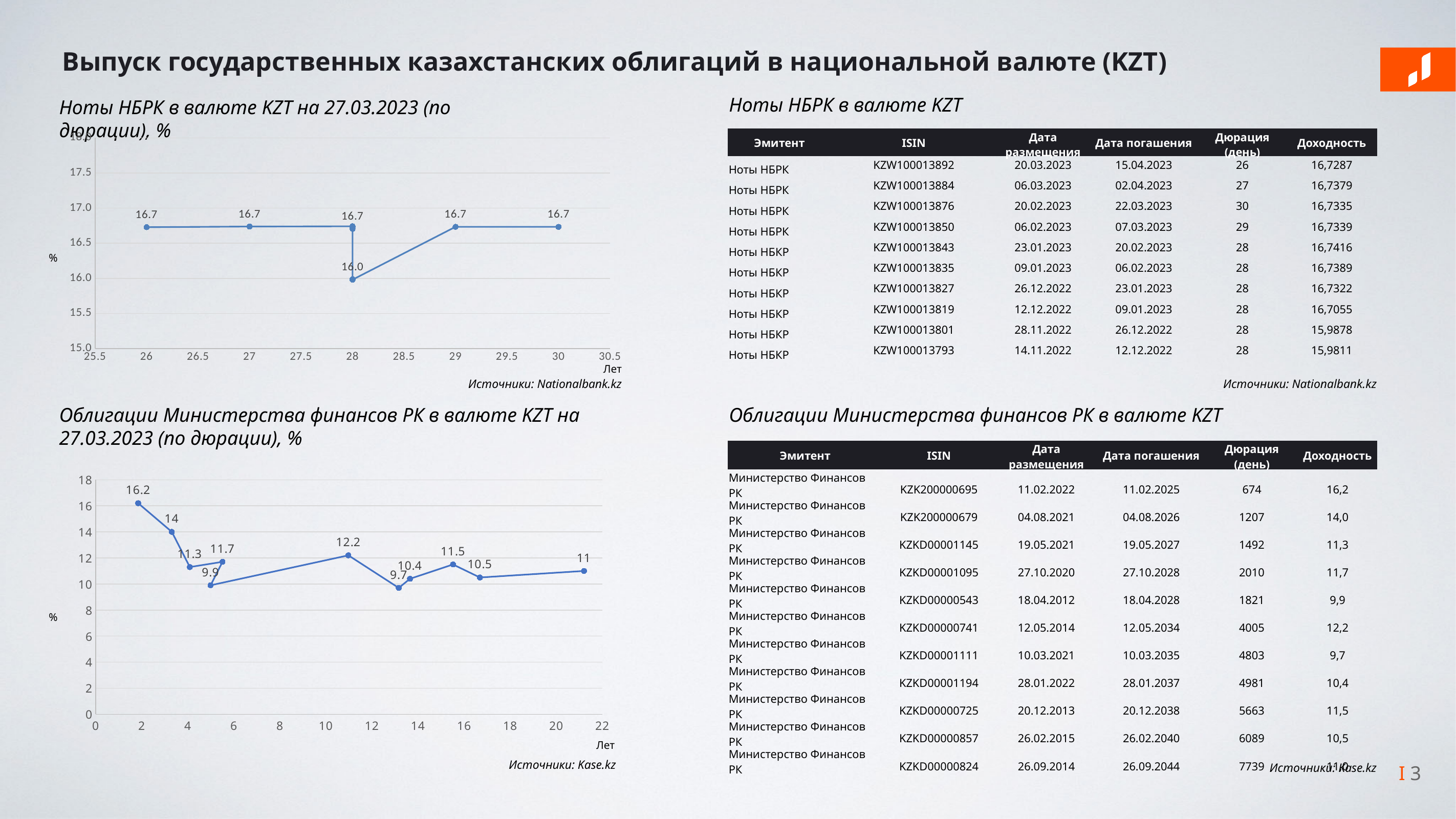
In the bottom-left chart (Облигации Министерства финансов РК), what is the highest plotted value? 16.2 In the top-left chart (Ноты НБРК), what is the lowest plotted value? 16.0 In the bottom-left chart (Облигации Министерства финансов РК), do the values overall rise or fall from the leftmost point to the rightmost point? fall In the bottom-left chart (Облигации Министерства финансов РК), how many data points are plotted? 11 What is the x-axis label of the bottom-left chart (Облигации Министерства финансов РК)? Лет In the bottom-left chart (Облигации Министерства финансов РК), what is the lowest plotted value? 9.7 In the bottom-left chart (Облигации Министерства финансов РК), is the value of the rightmost point (at about 21 years) greater or less than 10? greater In the top-left chart (Ноты НБРК), what is the difference between the highest value 16.7 and the lowest value 16.0? 0.7 In the top-left chart (Ноты НБРК), what is the value plotted at 26 years? 16.7 In the bottom-left chart (Облигации Министерства финансов РК), what is the difference between the highest value 16.2 and the lowest value 9.7? 6.5 What kind of chart is the top-left chart titled "Ноты НБРК в валюте KZT на 27.03.2023 (по дюрации), %"? line chart